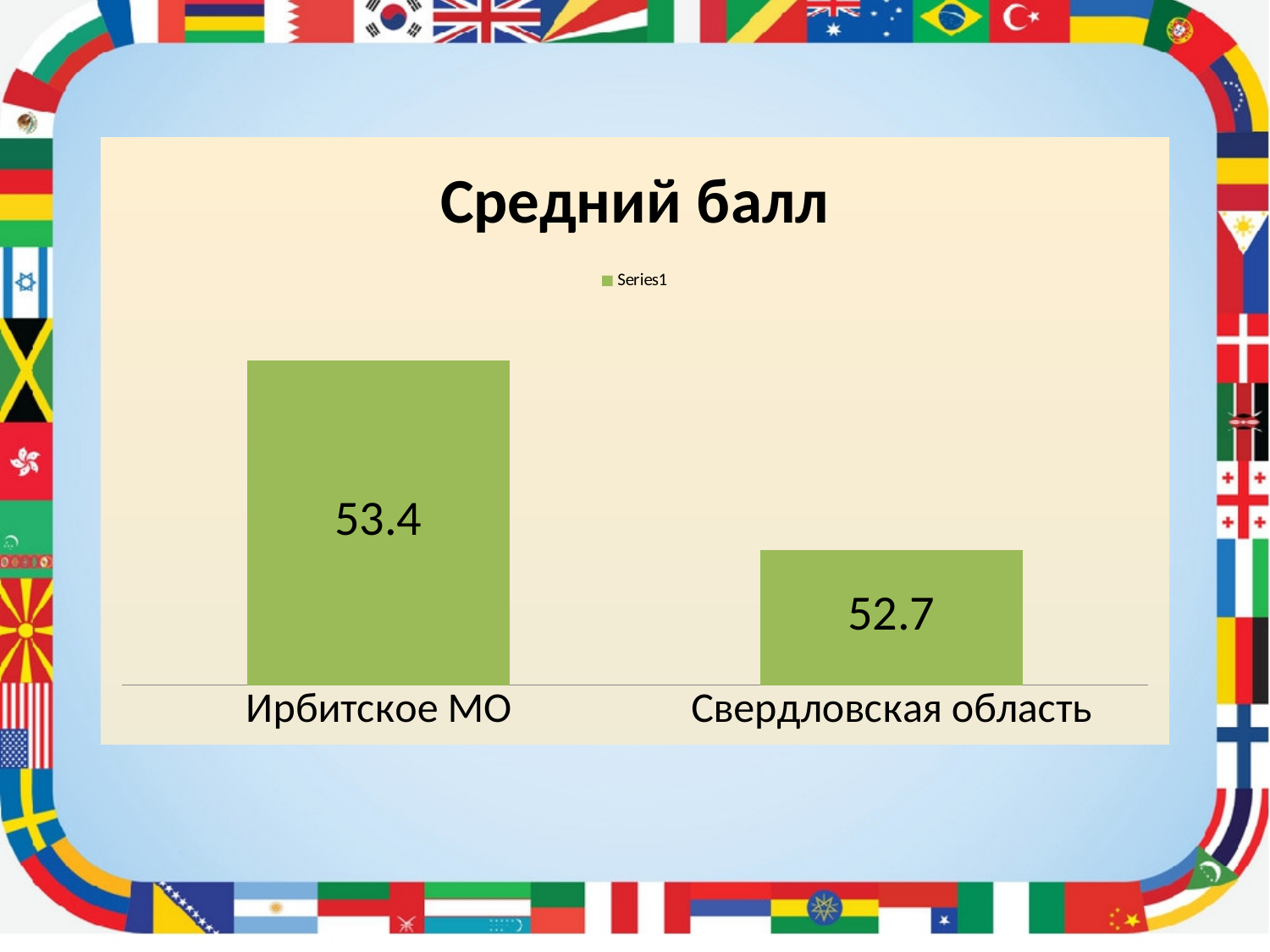
How many series does the legend list? 1 What is the difference between the values for Ирбитское МО and Свердловская область? 0.7 Which is larger, the value for Ирбитское МО or for Свердловская область? Ирбитское МО What is the value for Ирбитское МО? 53.4 How many categories are shown in the chart? 2 What is the value for Свердловская область? 52.7 Which category has the highest value? Ирбитское МО What kind of chart is shown on the slide? bar chart What is the name of the series shown in the legend? Series1 What is the title of the chart? Средний балл Which category has the lowest value? Свердловская область